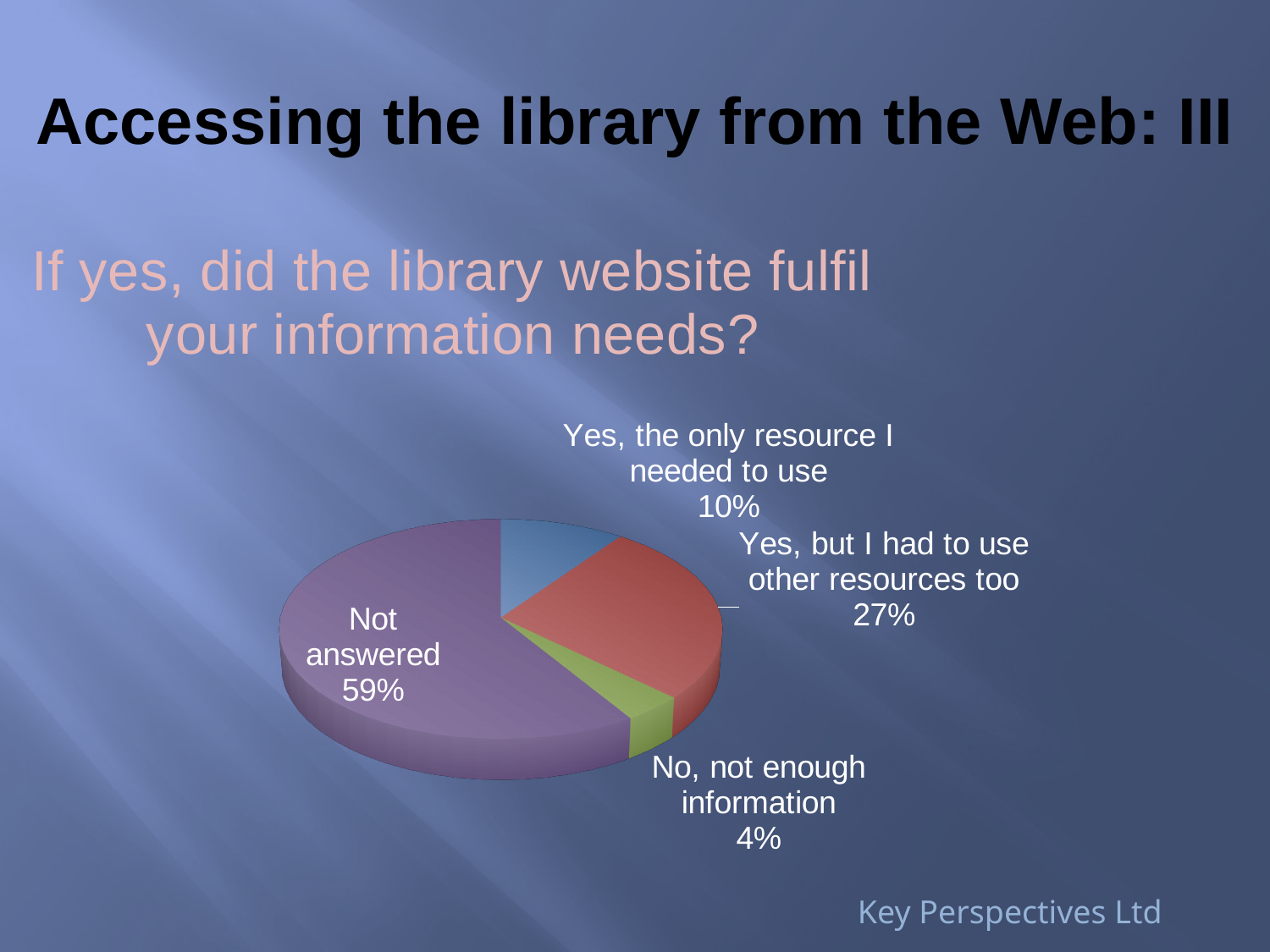
How many slices does the pie chart have? 4 What percentage is shown for "No, not enough information"? 4% What is the difference in percentage points between "Yes, but I had to use other resources too" and "Yes, the only resource I needed to use"? 17 Which is larger: the share for "Yes, the only resource I needed to use" or the share for "No, not enough information"? Yes, the only resource I needed to use Which slice of the pie is the smallest? No, not enough information What percentage is shown for "Yes, but I had to use other resources too"? 27% What percentage is shown for "Yes, the only resource I needed to use"? 10% What kind of chart is shown on the slide? pie chart Which slice of the pie is the largest? Not answered What is the difference in percentage points between "Not answered" and "Yes, but I had to use other resources too"? 32 What share of the pie is labelled "Not answered"? 59% What question does the chart on the slide present responses to? If yes, did the library website fulfil your information needs?